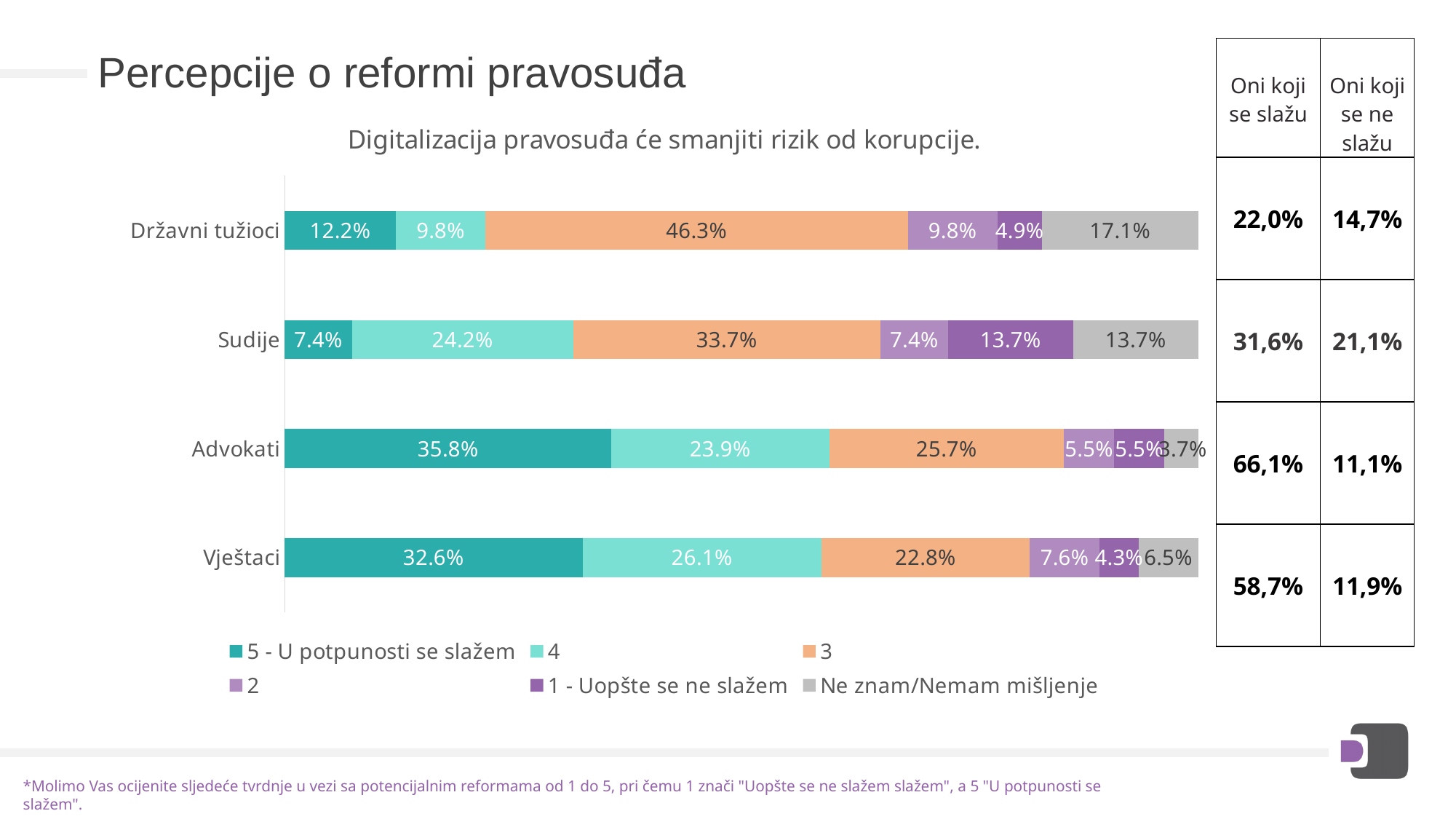
How many series does the legend list? 6 How many categories are shown on the chart? 4 What is the title of the chart? Digitalizacija pravosuđa će smanjiti rizik od korupcije. What percentage of Državni tužioci gave a rating of 3? 46.3% What is the value for Advokati in the "5 - U potpunosti se slažem" series? 35.8% What percentage of Vještaci gave a rating of 4? 26.1% Which category has the highest value for "5 - U potpunosti se slažem"? Advokati What is the difference between the "5 - U potpunosti se slažem" values for Advokati and Državni tužioci? 23.6% What kind of chart is shown on the slide? Stacked bar chart Which category has the lowest value for "5 - U potpunosti se slažem"? Sudije What percentage of Sudije answered "1 - Uopšte se ne slažem"? 13.7% Which is larger: the rating-4 value for Sudije or for Vještaci? Vještaci